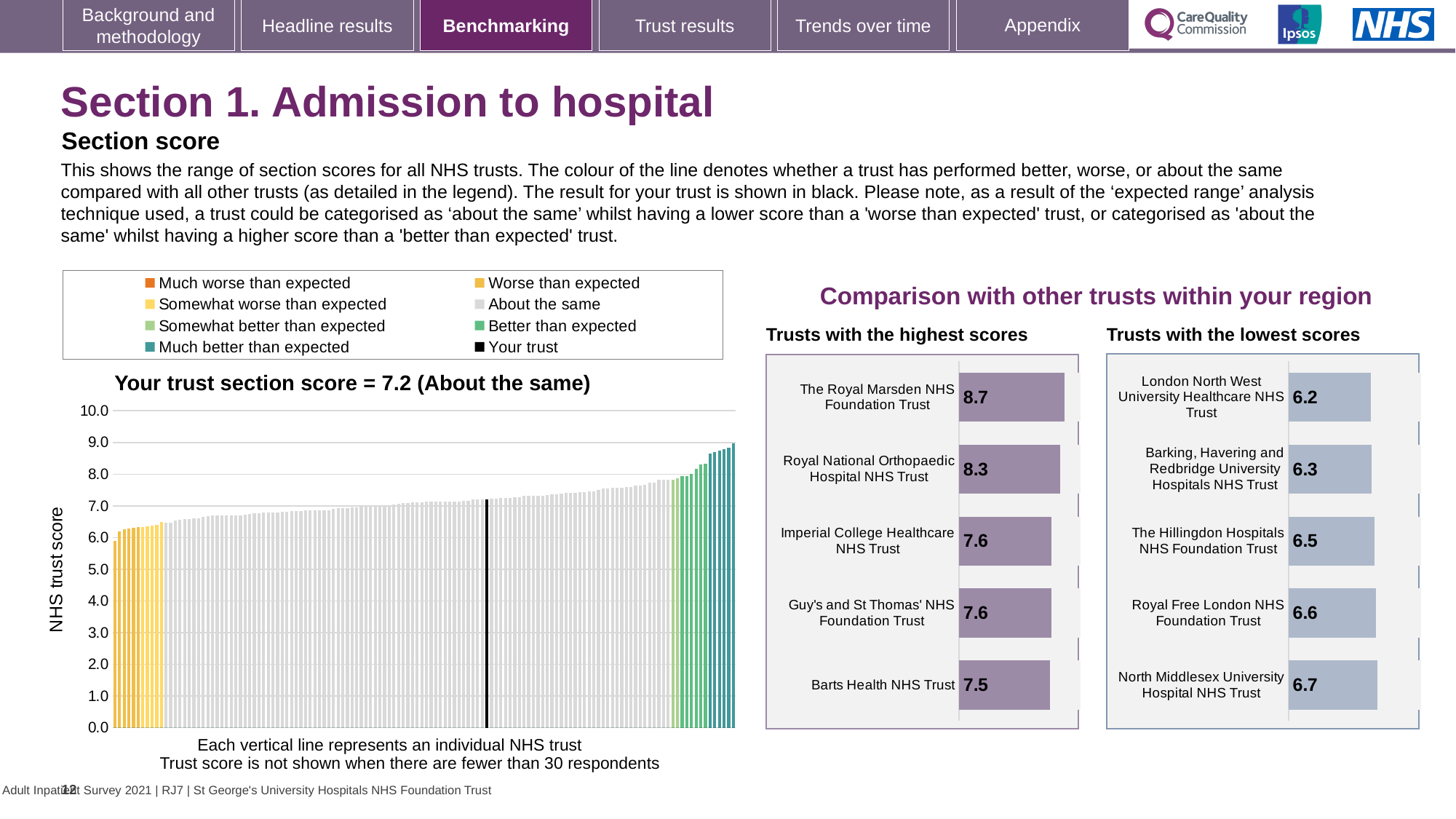
In the 'Your trust section score' chart, what is the section score for your trust? 7.2 In the 'Your trust section score' chart, how many entries does the legend list? 8 In the 'Trusts with the highest scores' chart, what is the score for The Royal Marsden NHS Foundation Trust? 8.7 In the 'Your trust section score' chart, do the trust scores rise or fall from left to right along the x axis? rise In the 'Trusts with the lowest scores' chart, which has the larger score: Royal Free London NHS Foundation Trust or Barking, Havering and Redbridge University Hospitals NHS Trust? Royal Free London NHS Foundation Trust In the 'Trusts with the lowest scores' chart, what is the score for The Hillingdon Hospitals NHS Foundation Trust? 6.5 In the 'Trusts with the highest scores' chart, what is the difference between the scores of The Royal Marsden NHS Foundation Trust and Barts Health NHS Trust? 1.2 In the 'Your trust section score' chart, what is the label on the vertical axis? NHS trust score In the 'Trusts with the lowest scores' chart, which trust has the lowest score? London North West University Healthcare NHS Trust In the 'Trusts with the highest scores' chart, how many trusts are shown? 5 In the 'Your trust section score' chart, what kind of chart is shown? bar chart In the 'Trusts with the highest scores' chart, which trust has the highest score? The Royal Marsden NHS Foundation Trust